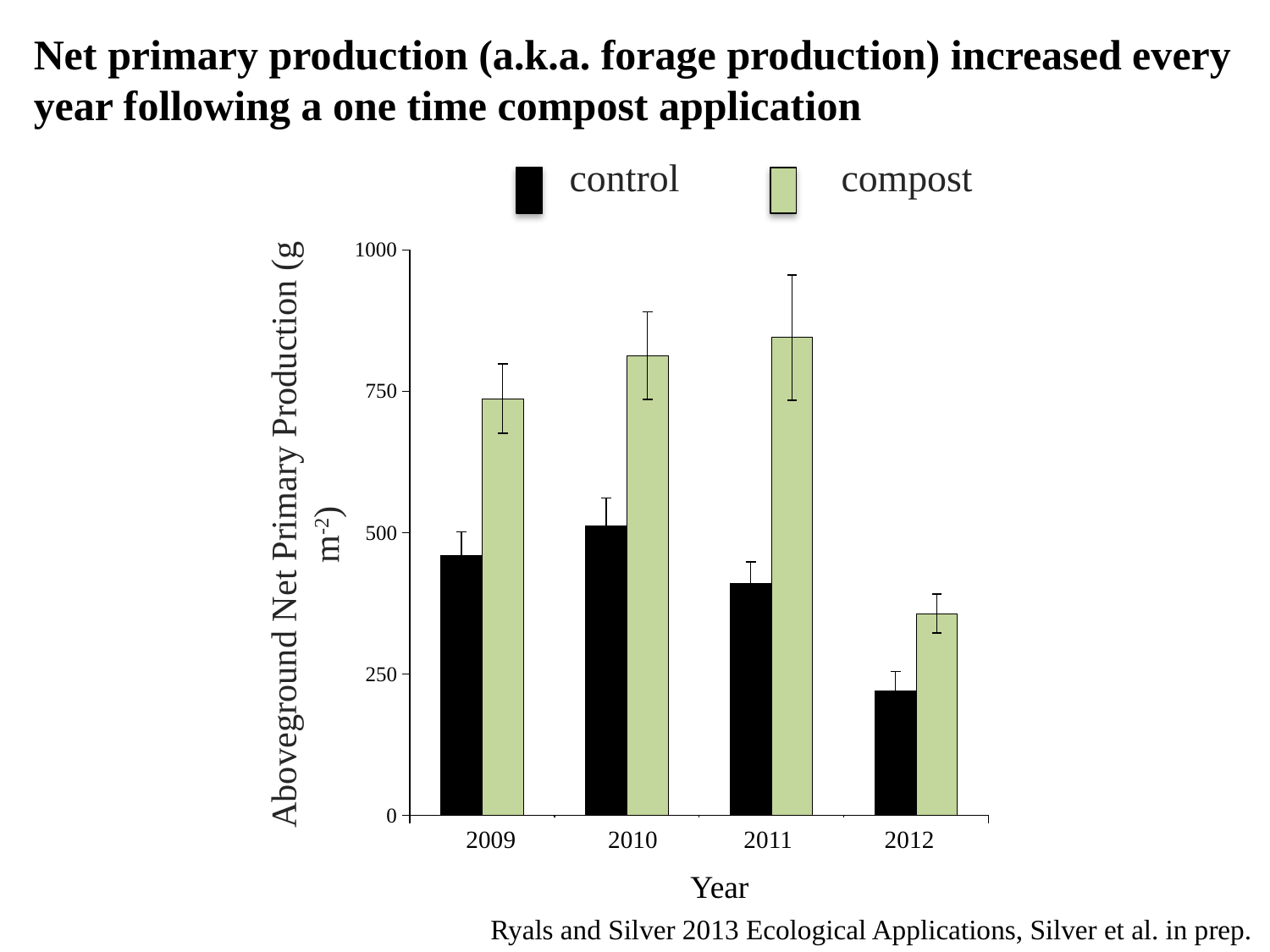
What is the label of the x axis? Year Which series is shown with black bars? control Is the compost value for 2012 greater or less than 250? greater Is the control value for 2012 greater or less than 250? less Is the control value for 2011 greater or less than 500? less In 2009, which is larger, the control value or the compost value? compost In which year is the control value highest? 2010 How many years are shown on the x axis? 4 What kind of chart is shown on the slide? bar chart How many series does the legend list? 2 In which year is the compost value lowest? 2012